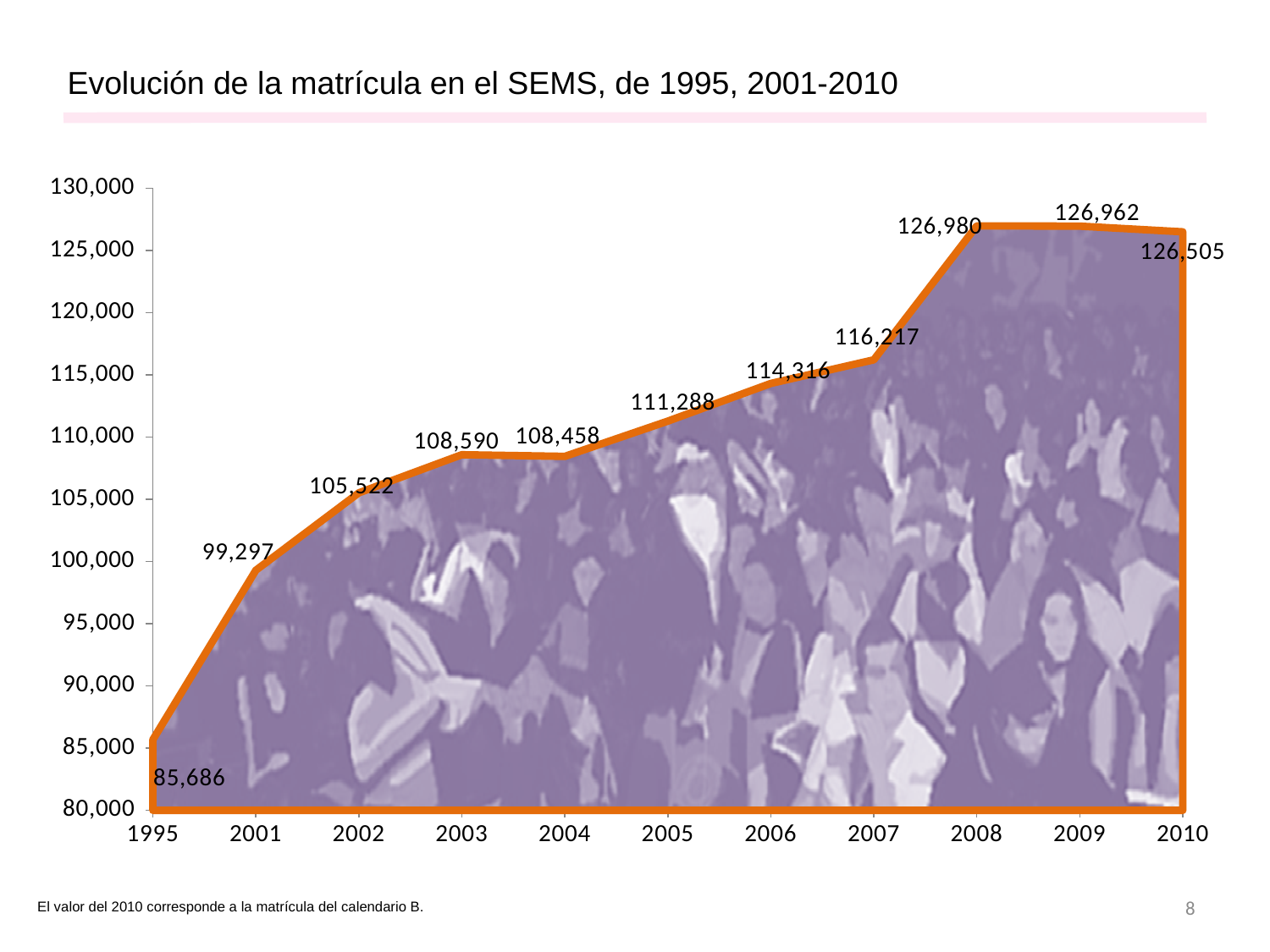
Do the enrollment values generally rise or fall from 1995 to 2008? Rise How many years (data points) are plotted on the x axis? 11 What type of chart is shown on the slide? Area chart What was the enrollment (matrícula) in the SEMS in 1995? 85,686 What value is shown for 2005? 111,288 What is the difference between the 2010 value and the 1995 value? 40,819 Is the value for 2006 greater or less than 110,000? greater What is the difference between the 2008 value and the 2007 value? 10,763 Which year has the larger value, 2003 or 2004? 2003 What value is shown for 2010? 126,505 What value is shown for 2008? 126,980 Which year has the lowest enrollment value? 1995